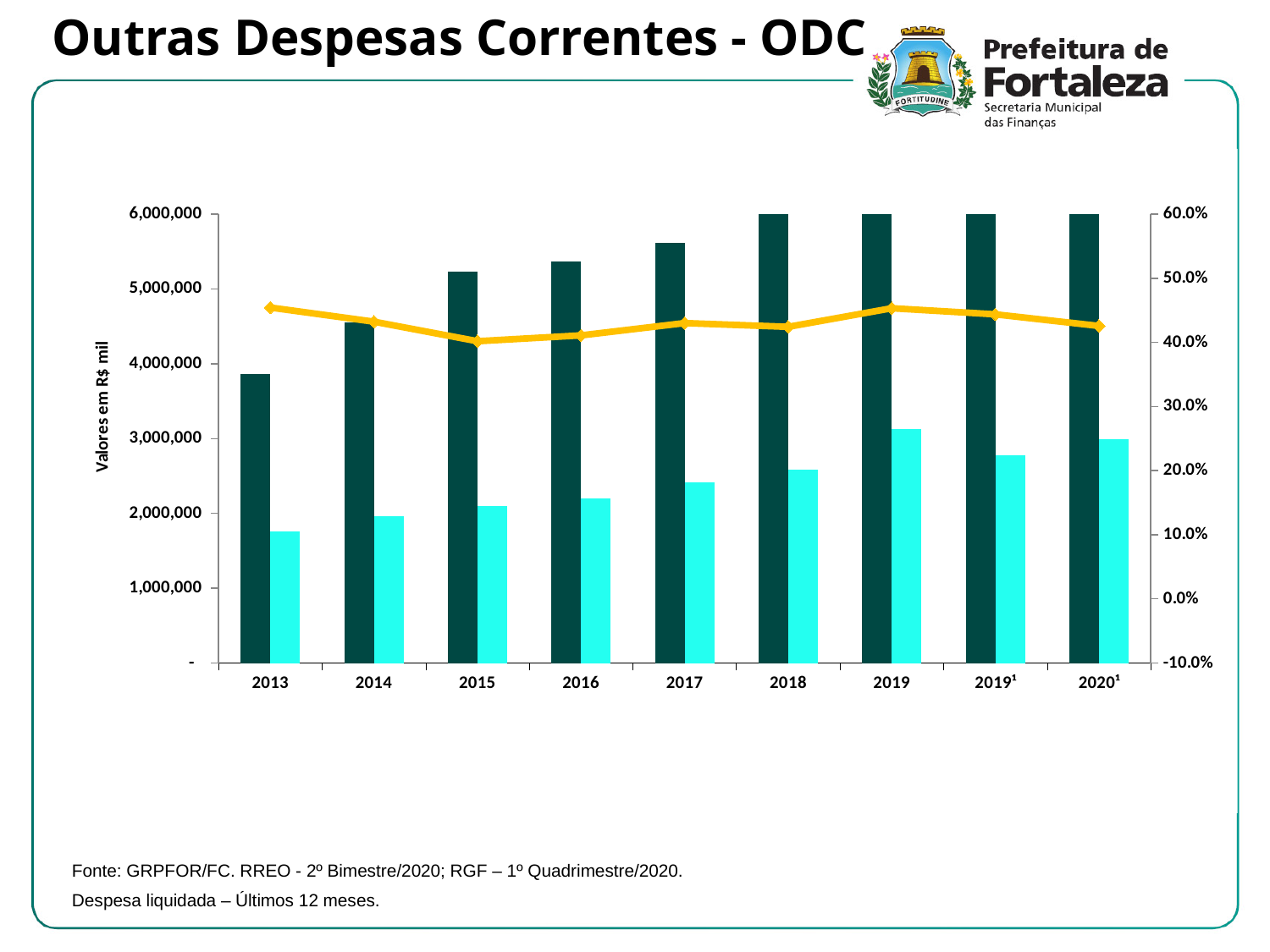
What is the title of the chart on the slide? Outras Despesas Correntes - ODC Is the value of the dark green bar for 2017 greater or less than 5,000,000? greater What kind of chart is shown on the slide? Combined bar and line chart What is the label of the left vertical axis? Valores em R$ mil Is the value of the cyan bar for 2013 greater or less than 2,000,000? less Do the cyan bars rise or fall from 2013 to 2019? rise Is the value of the cyan bar for 2019 greater or less than 3,000,000? greater Which category has the highest cyan bar? 2019 Which category has the lowest dark green bar? 2013 How many categories are shown on the x axis of the chart? 9